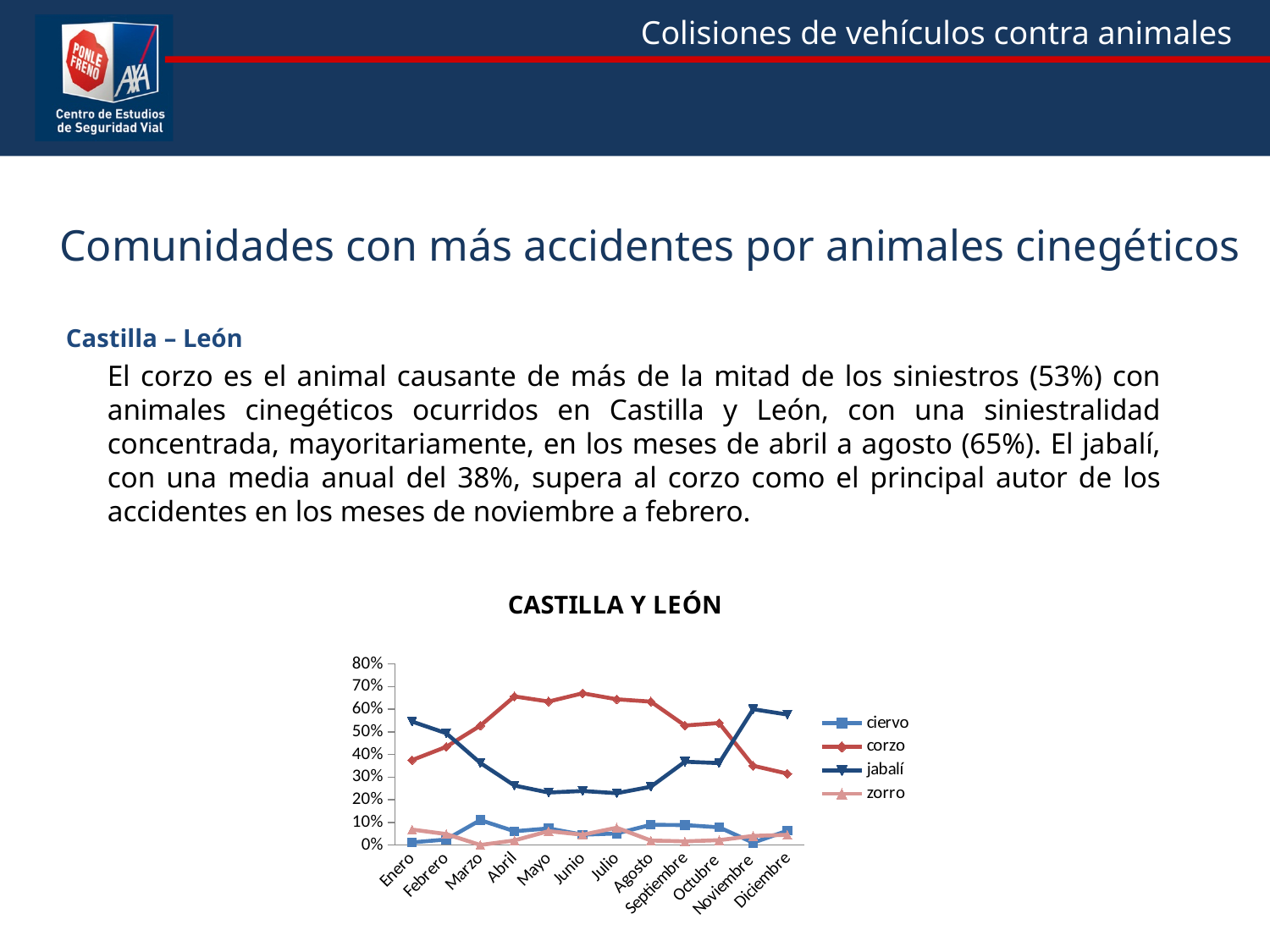
Which series is drawn with triangle markers in the chart? zorro Does the corzo line rise or fall from Enero to Abril? rise Is the value for jabalí in Enero greater or less than 50%? greater What is the title of the chart? CASTILLA Y LEÓN Is the value for corzo in Junio greater or less than 60%? greater What kind of chart is shown on the slide? line chart Is the value for corzo in Enero greater or less than 40%? less How many months are plotted along the x axis of the CASTILLA Y LEÓN chart? 12 In Enero, which series has the higher value, corzo or jabalí? jabalí In Junio, which series has the higher value, corzo or jabalí? corzo How many series does the legend of the CASTILLA Y LEÓN chart list? 4